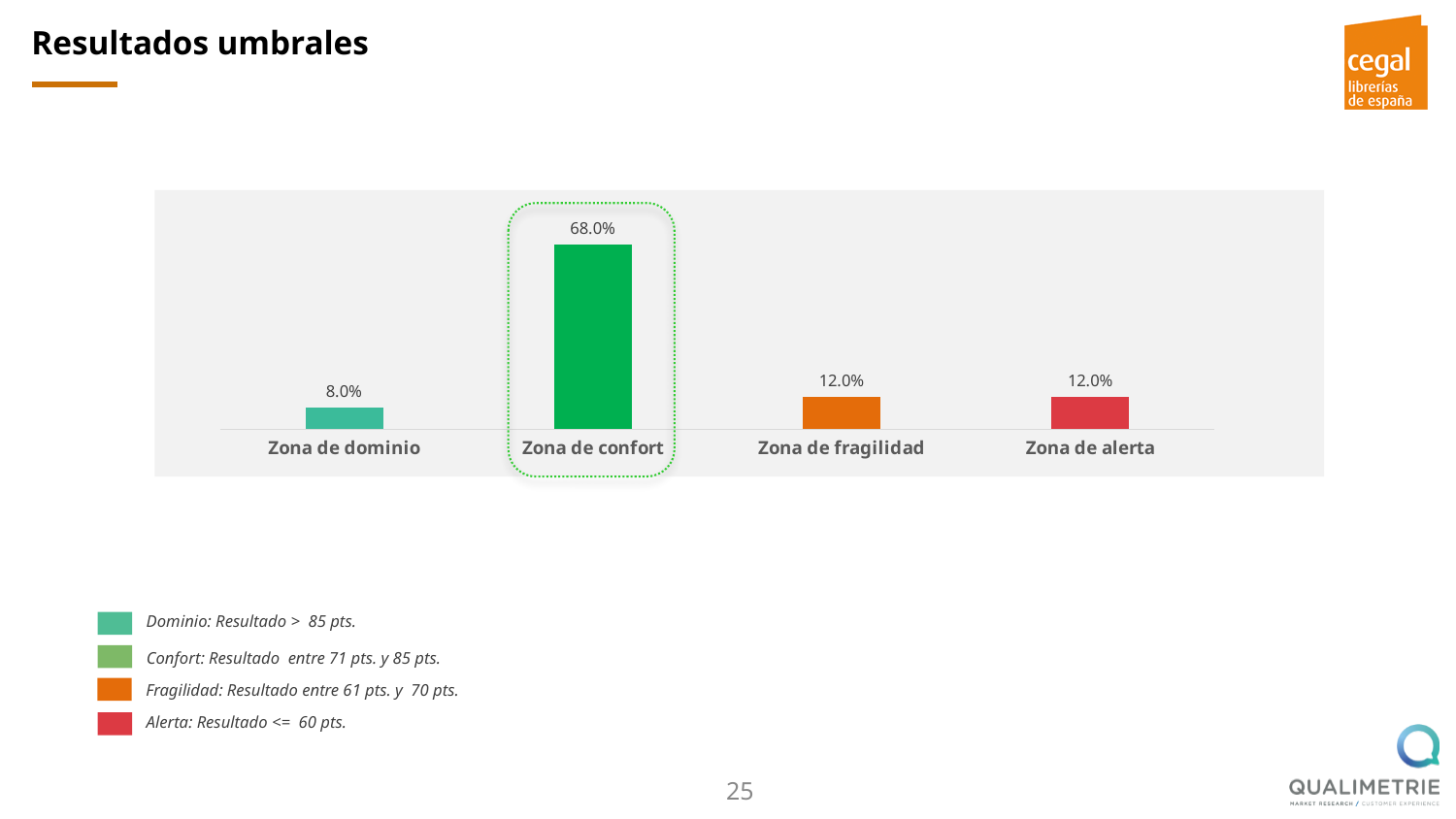
Which category has the lowest value? Zona de dominio How many categories are shown in the chart? 4 What is the difference between the values for Zona de fragilidad and Zona de dominio? 4.0% What is the value for Zona de confort? 68.0% Which is larger, the value for Zona de confort or the value for Zona de alerta? Zona de confort What is the title of the slide containing the chart? Resultados umbrales What is the value for Zona de fragilidad? 12.0% Which category has the highest value? Zona de confort What is the value for Zona de alerta? 12.0% What is the difference between the values for Zona de confort and Zona de dominio? 60.0% What is the value for Zona de dominio? 8.0% What kind of chart is shown on the slide? Bar chart